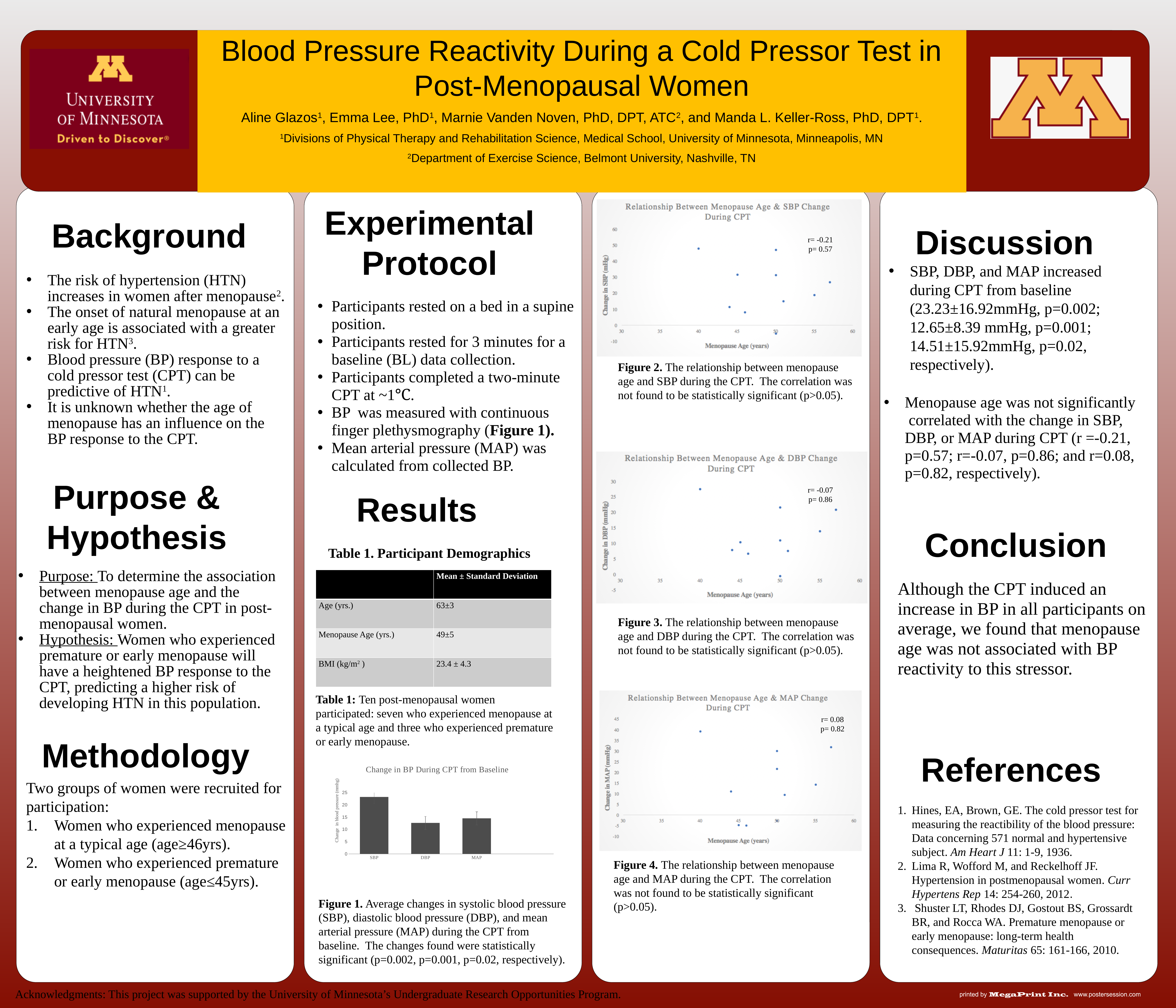
In the 'Change in BP During CPT from Baseline' bar chart, which category has the highest bar? SBP What kind of chart is the 'Change in BP During CPT from Baseline' chart (Figure 1)? Bar chart What correlation coefficient r is printed on the 'Relationship Between Menopause Age & MAP Change During CPT' chart? r= 0.08 How many categories are shown on the x axis of the 'Change in BP During CPT from Baseline' bar chart? 3 What p value is printed on the 'Relationship Between Menopause Age & DBP Change During CPT' chart? p= 0.86 What is the x-axis label of the 'Relationship Between Menopause Age & MAP Change During CPT' chart? Menopause Age (years) In the 'Change in BP During CPT from Baseline' bar chart, is the value for DBP greater or less than 15? less In the 'Change in BP During CPT from Baseline' bar chart, is the value for SBP greater or less than 20? greater What kind of chart is 'Relationship Between Menopause Age & SBP Change During CPT' (Figure 2)? Scatter plot In the 'Change in BP During CPT from Baseline' bar chart, which is larger, the bar for SBP or the bar for MAP? SBP What correlation coefficient r is printed on the 'Relationship Between Menopause Age & SBP Change During CPT' chart? r= -0.21 In the 'Change in BP During CPT from Baseline' bar chart, which category has the lowest bar? DBP